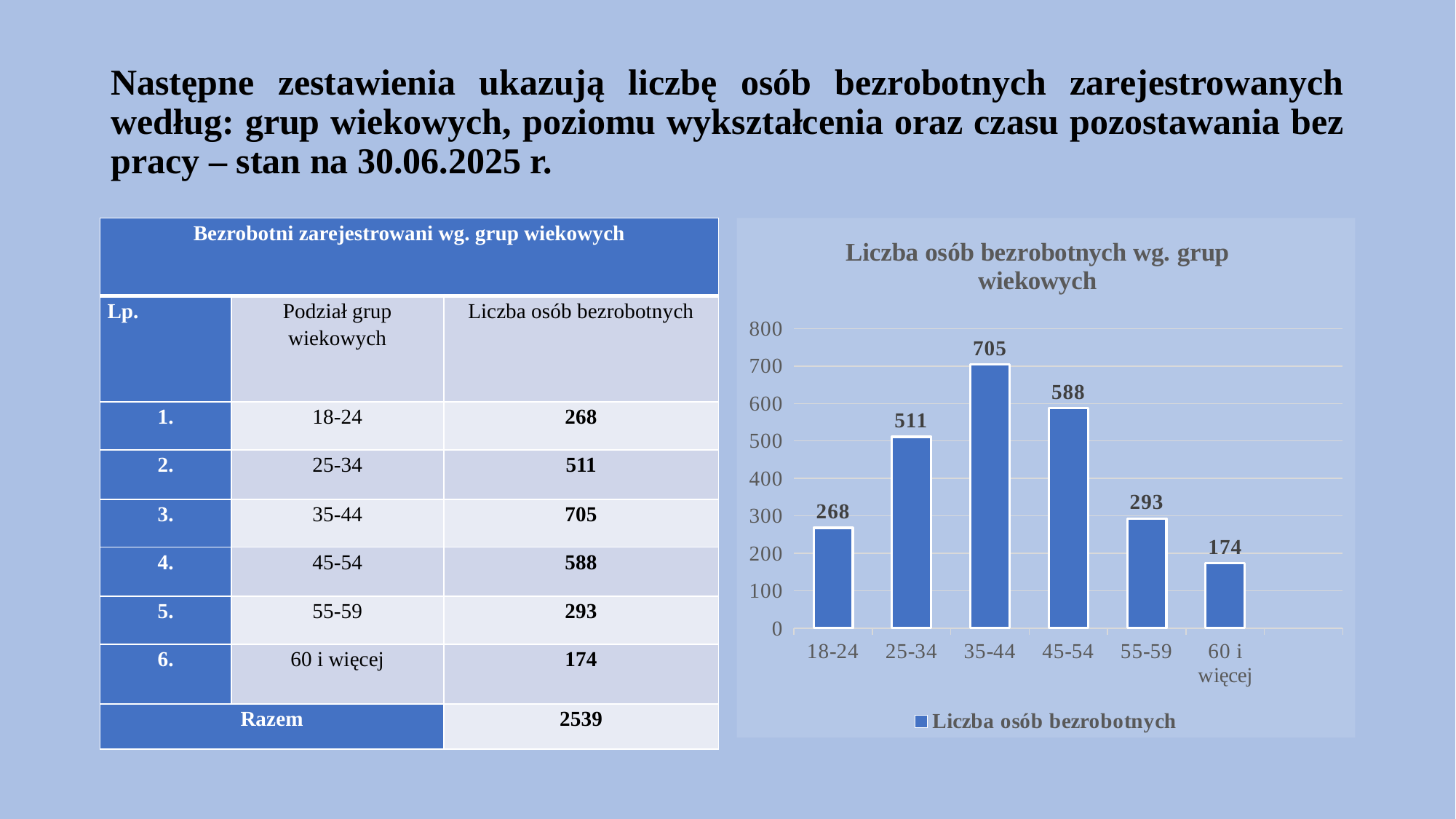
How many age groups are shown in the chart? 6 What kind of chart is shown on the slide? bar chart Which age group has the lowest number of unemployed persons in the chart? 60 i więcej What is the value for the 25-34 age group in the chart? 511 What is the value for the 60 i więcej age group in the chart? 174 What is the difference between the values for the 35-44 and 45-54 age groups? 117 Is the value for the 45-54 age group greater or less than 500? greater How many series does the chart legend list? 1 What is the value for the 35-44 age group in the chart? 705 Which is larger, the value for 18-24 or the value for 55-59? 55-59 What is the title of the chart? Liczba osób bezrobotnych wg. grup wiekowych Which age group has the highest number of unemployed persons in the chart? 35-44